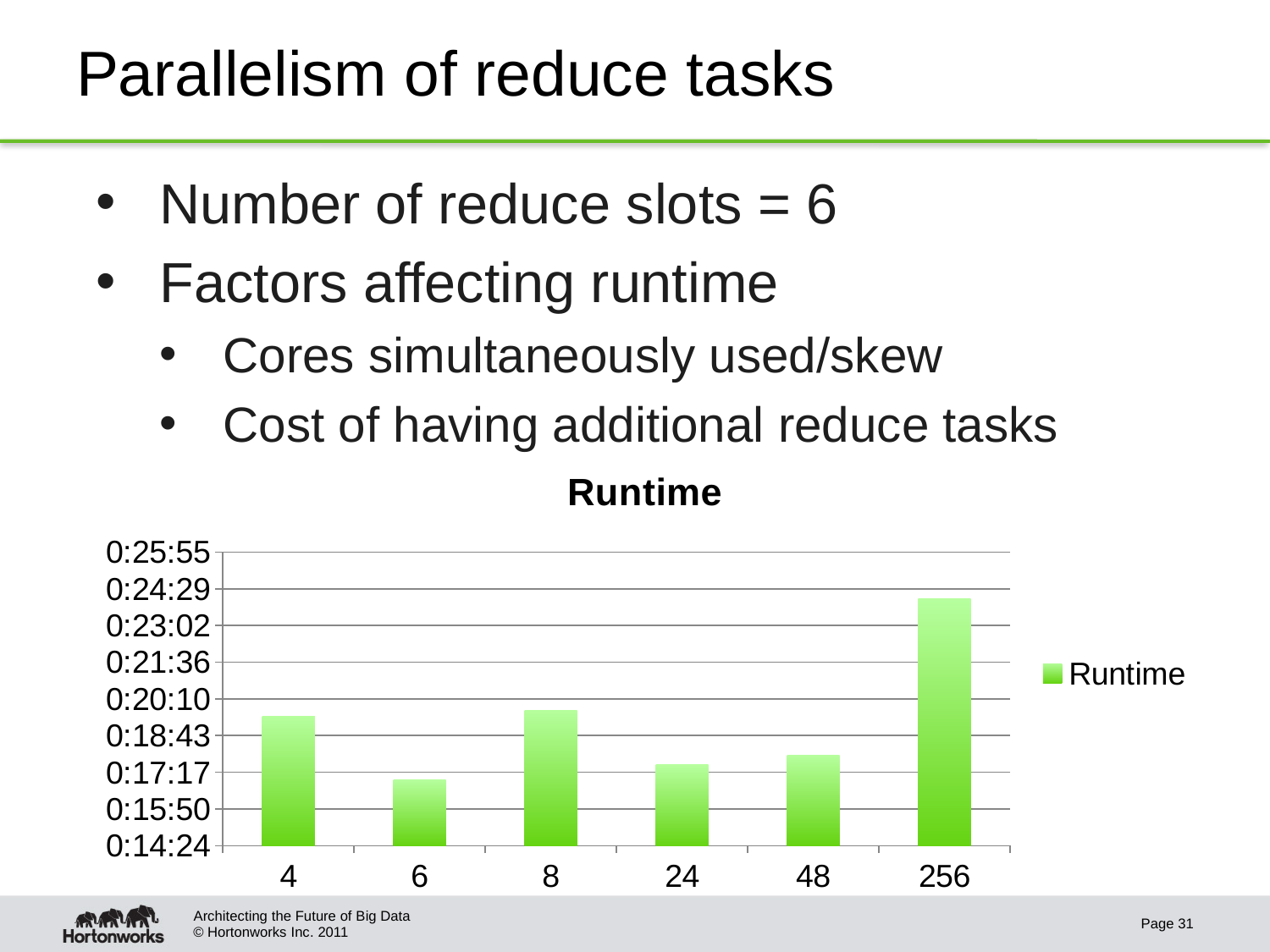
What type of chart is shown on the slide? bar chart How many categories are shown on the x axis of the chart? 6 What is the title of the chart? Runtime How many series does the chart's legend list? 1 Is the runtime for 4 greater or less than 0:18:43? greater Is the runtime for 6 greater or less than 0:17:17? less Which has the larger runtime, 24 or 48? 48 Is the runtime for 256 greater or less than 0:23:02? greater Which has the larger runtime, 6 or 256? 256 Which category has the highest runtime? 256 Which category has the lowest runtime? 6